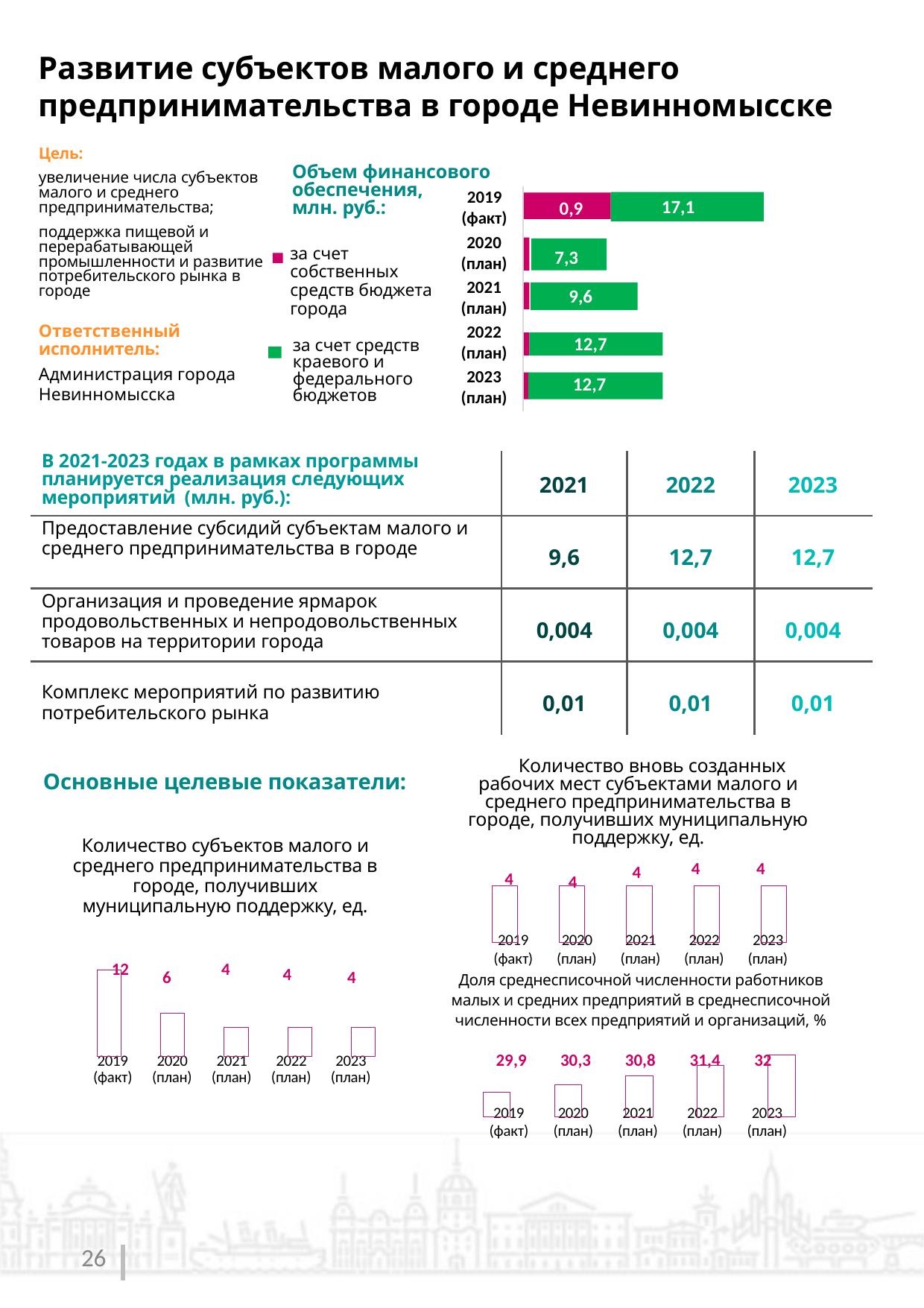
In the chart 'Объем финансового обеспечения, млн. руб.', what is the value for 2019 (факт) from the city's own budget (за счет собственных средств бюджета города)? 0,9 In the chart 'Объем финансового обеспечения, млн. руб.', what is the total of the stacked bar for 2019 (факт)? 18,0 In the chart 'Объем финансового обеспечения, млн. руб.', what is the value for 2019 (факт) from regional and federal budgets (за счет средств краевого и федерального бюджетов)? 17,1 In the chart 'Объем финансового обеспечения, млн. руб.', what is the difference between the green values for 2022 (план) and 2020 (план)? 5,4 In the chart 'Доля среднесписочной численности работников малых и средних предприятий в среднесписочной численности всех предприятий и организаций, %', do the values rise or fall from 2019 to 2023? Rise In the chart 'Количество субъектов малого и среднего предпринимательства в городе, получивших муниципальную поддержку, ед.', how many years are shown? 5 In the chart 'Количество субъектов малого и среднего предпринимательства в городе, получивших муниципальную поддержку, ед.', which year has the highest value? 2019 (факт) In the chart 'Объем финансового обеспечения, млн. руб.', what is the labelled value for 2021 (план)? 9,6 In the chart 'Доля среднесписочной численности работников малых и средних предприятий в среднесписочной численности всех предприятий и организаций, %', what is the value for 2021 (план)? 30,8 In the chart 'Объем финансового обеспечения, млн. руб.', how many series does the legend list? 2 In the chart 'Количество субъектов малого и среднего предпринимательства в городе, получивших муниципальную поддержку, ед.', what is the value for 2020 (план)? 6 What kind of chart is 'Объем финансового обеспечения, млн. руб.'? Stacked bar chart